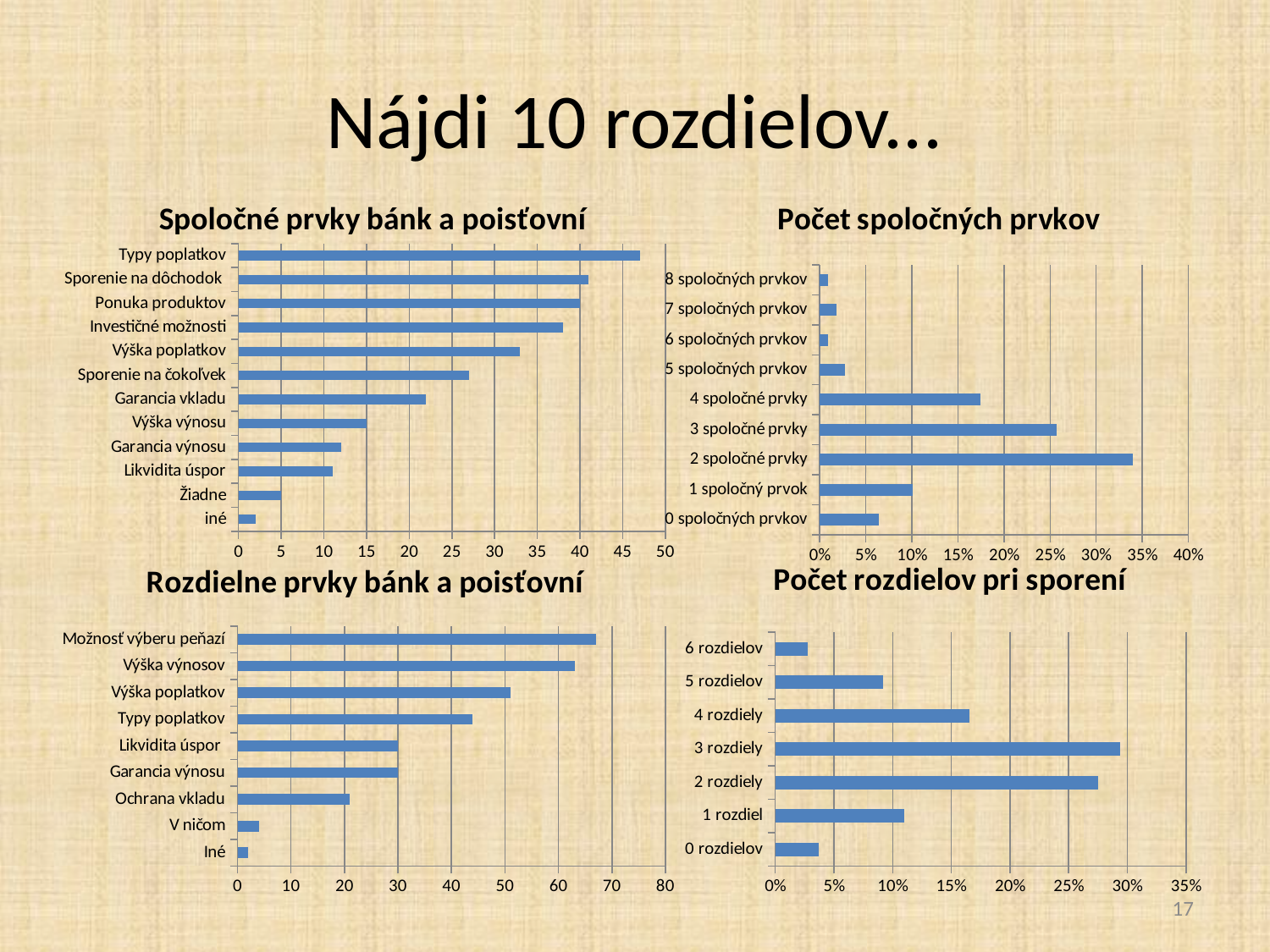
In the chart titled "Rozdielne prvky bánk a poisťovní", which is larger: Výška výnosov or Výška poplatkov? Výška výnosov In the chart titled "Počet spoločných prvkov", which category has the highest value? 2 spoločné prvky In the chart titled "Počet rozdielov pri sporení", is the value for 3 rozdiely greater or less than 25%? greater How many categories are shown in the chart titled "Počet spoločných prvkov"? 9 What type of chart is the chart titled "Počet rozdielov pri sporení"? bar chart In the chart titled "Počet spoločných prvkov", is the value for 4 spoločné prvky greater or less than 15%? greater In the chart titled "Spoločné prvky bánk a poisťovní", is the value for Výška poplatkov greater or less than 30? greater In the chart titled "Spoločné prvky bánk a poisťovní", which category has the lowest value? iné In the chart titled "Spoločné prvky bánk a poisťovní", which is larger: Investičné možnosti or Výška poplatkov? Investičné možnosti In the chart titled "Rozdielne prvky bánk a poisťovní", which category has the highest value? Možnosť výberu peňazí In the chart titled "Spoločné prvky bánk a poisťovní", which category has the highest value? Typy poplatkov How many categories are shown in the chart titled "Spoločné prvky bánk a poisťovní"? 12